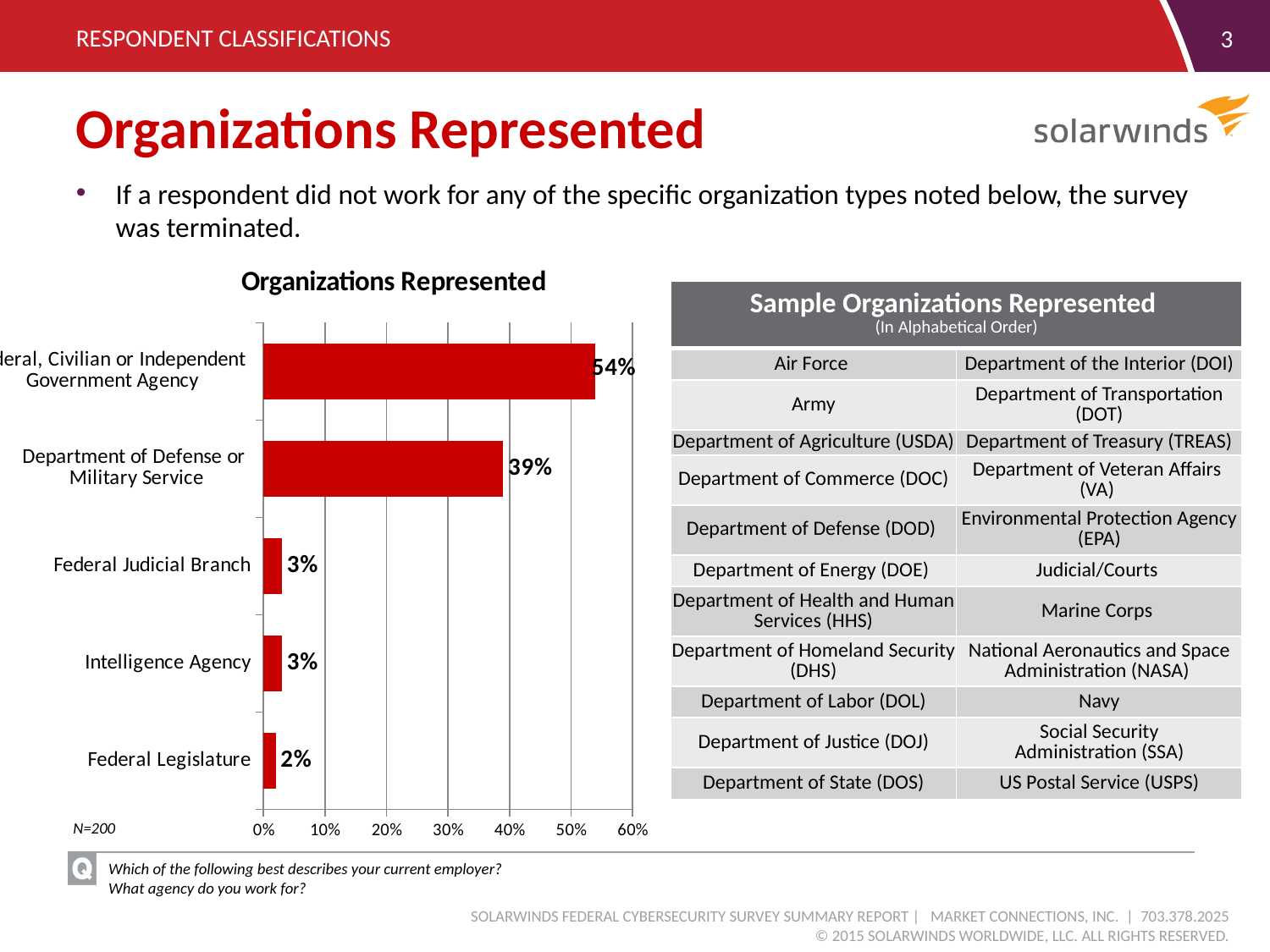
In the Organizations Represented chart, what percentage is shown for Intelligence Agency? 3% In the Organizations Represented chart, which category has the lowest percentage? Federal Legislature In the Organizations Represented chart, what percentage is shown for Federal Judicial Branch? 3% In the Organizations Represented chart, which category has the highest percentage? Federal, Civilian or Independent Government Agency In the Organizations Represented chart, is the value for Department of Defense or Military Service greater or less than 30%? greater What kind of chart is the Organizations Represented chart? Bar chart In the Organizations Represented chart, what percentage is shown for Federal Legislature? 2% What sample size (N) is noted below the Organizations Represented chart? N=200 In the Organizations Represented chart, what is the difference between the Civilian or Independent Government Agency value and the Department of Defense or Military Service value? 15% How many categories are shown in the Organizations Represented chart? 5 In the Organizations Represented chart, which is larger: Department of Defense or Military Service, or Federal Judicial Branch? Department of Defense or Military Service In the Organizations Represented chart, what percentage is shown for Department of Defense or Military Service? 39%